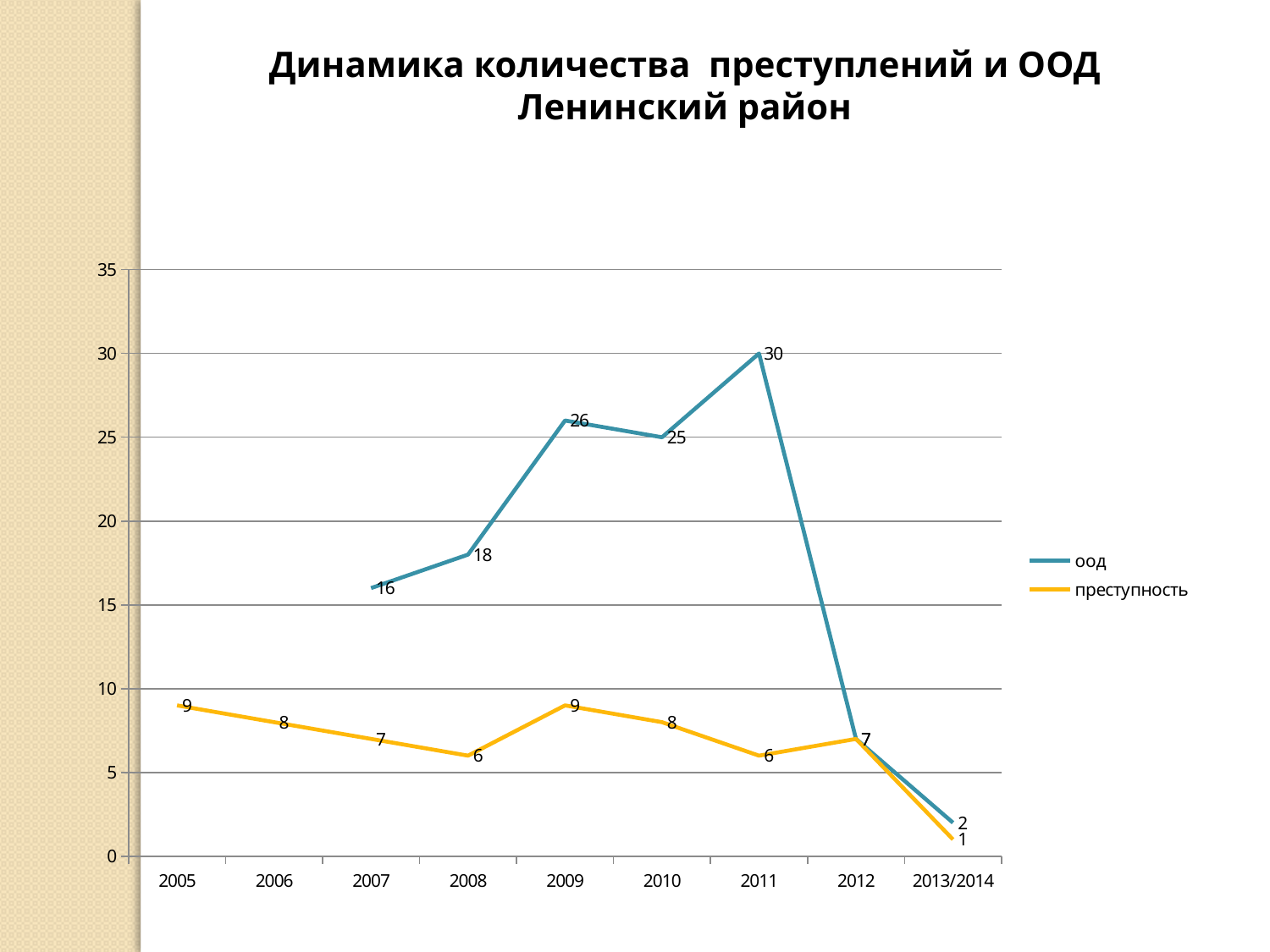
How many series does the legend list? 2 What type of chart is shown on the slide? line chart How many categories are shown on the x axis? 9 What is the value of оод in 2007? 16 In which year does оод reach its highest value? 2011 What is the value of оод in 2011? 30 In which year is преступность at its lowest value? 2013/2014 Which is larger: оод in 2009 or преступность in 2009? оод in 2009 What is the title of the chart? Динамика количества преступлений и ООД Ленинский район What is the difference between оод in 2011 and оод in 2010? 5 Does оод rise or fall from 2011 to 2013/2014? fall What is the value of преступность in 2008? 6